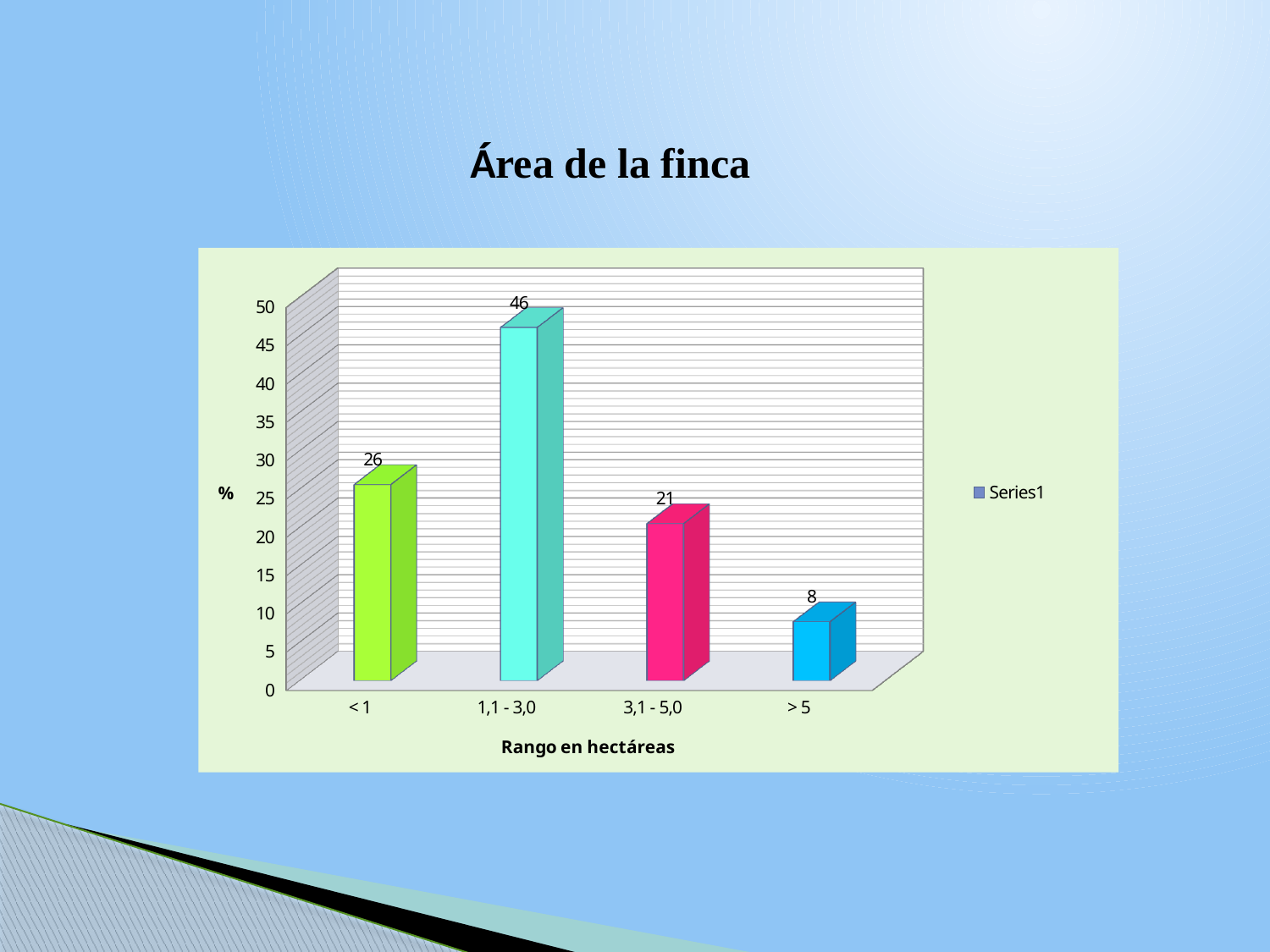
How many series does the legend list? 1 Which category has the lowest value? > 5 What is the value for the "1,1 - 3,0" category? 46 Which is larger, the value for "< 1" or the value for "3,1 - 5,0"? < 1 What is the value for the "3,1 - 5,0" category? 21 What is the difference between the values for "1,1 - 3,0" and "< 1"? 20 How many categories are shown on the x axis? 4 What is the value for the "< 1" category? 26 What is the title of the chart? Área de la finca Which category has the highest value? 1,1 - 3,0 What is the value for the "> 5" category? 8 What kind of chart is shown on the slide? Bar chart